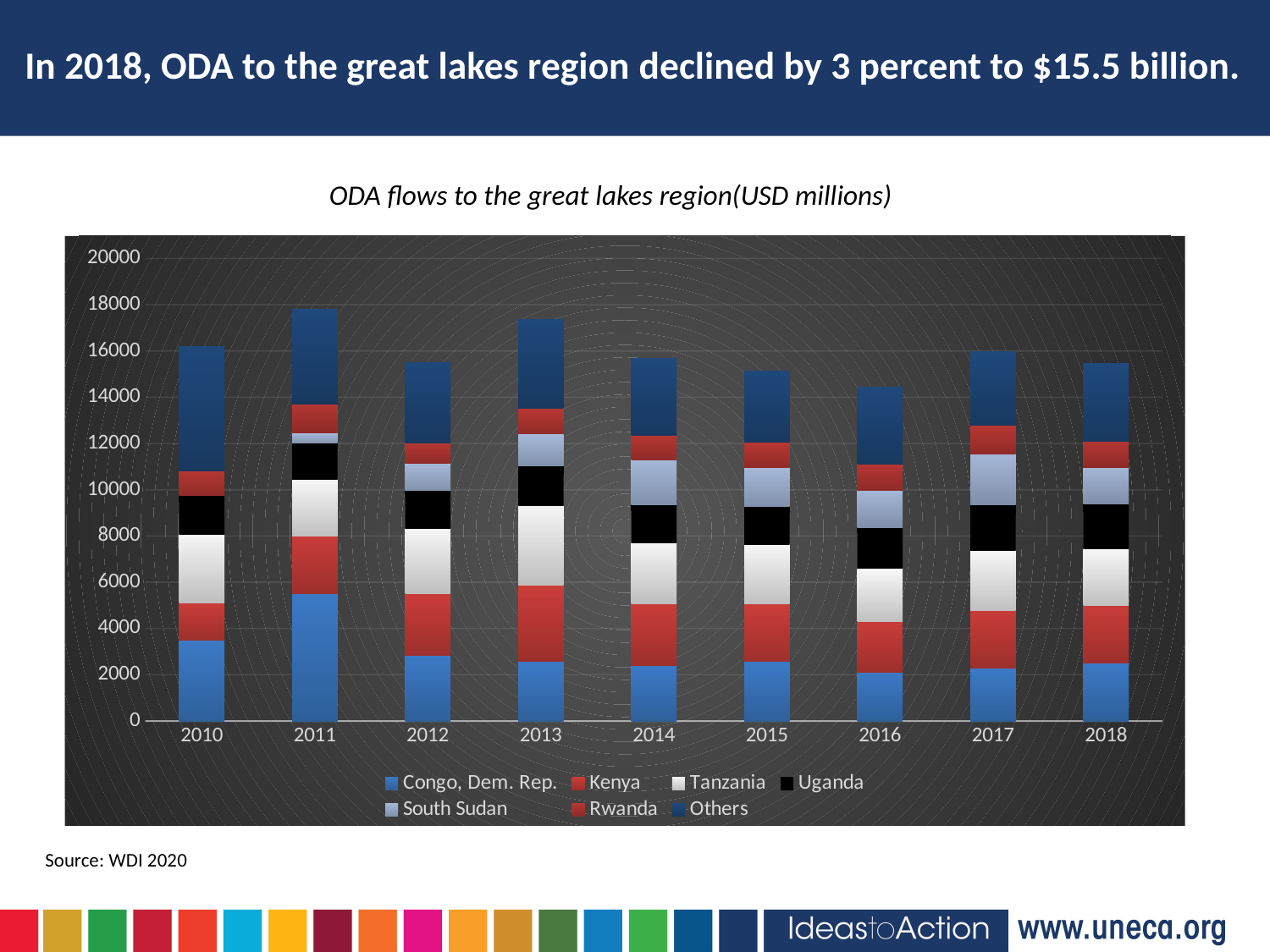
How many series does the chart's legend list? 7 How many years are shown on the x axis of the chart? 9 Is the Congo, Dem. Rep. segment for 2011 greater or less than 4000? greater What kind of chart is shown on the slide? Stacked bar chart Which year has the shortest stacked bar in the chart? 2016 Is the total stacked bar for 2016 greater or less than 16000? less Is the total stacked bar for 2011 greater or less than 16000? greater What is the title of the chart? ODA flows to the great lakes region(USD millions) Which series is shown at the bottom of each stacked bar? Congo, Dem. Rep. Which is larger, the Congo, Dem. Rep. segment in 2011 or in 2010? 2011 Which year has the tallest stacked bar in the chart? 2011